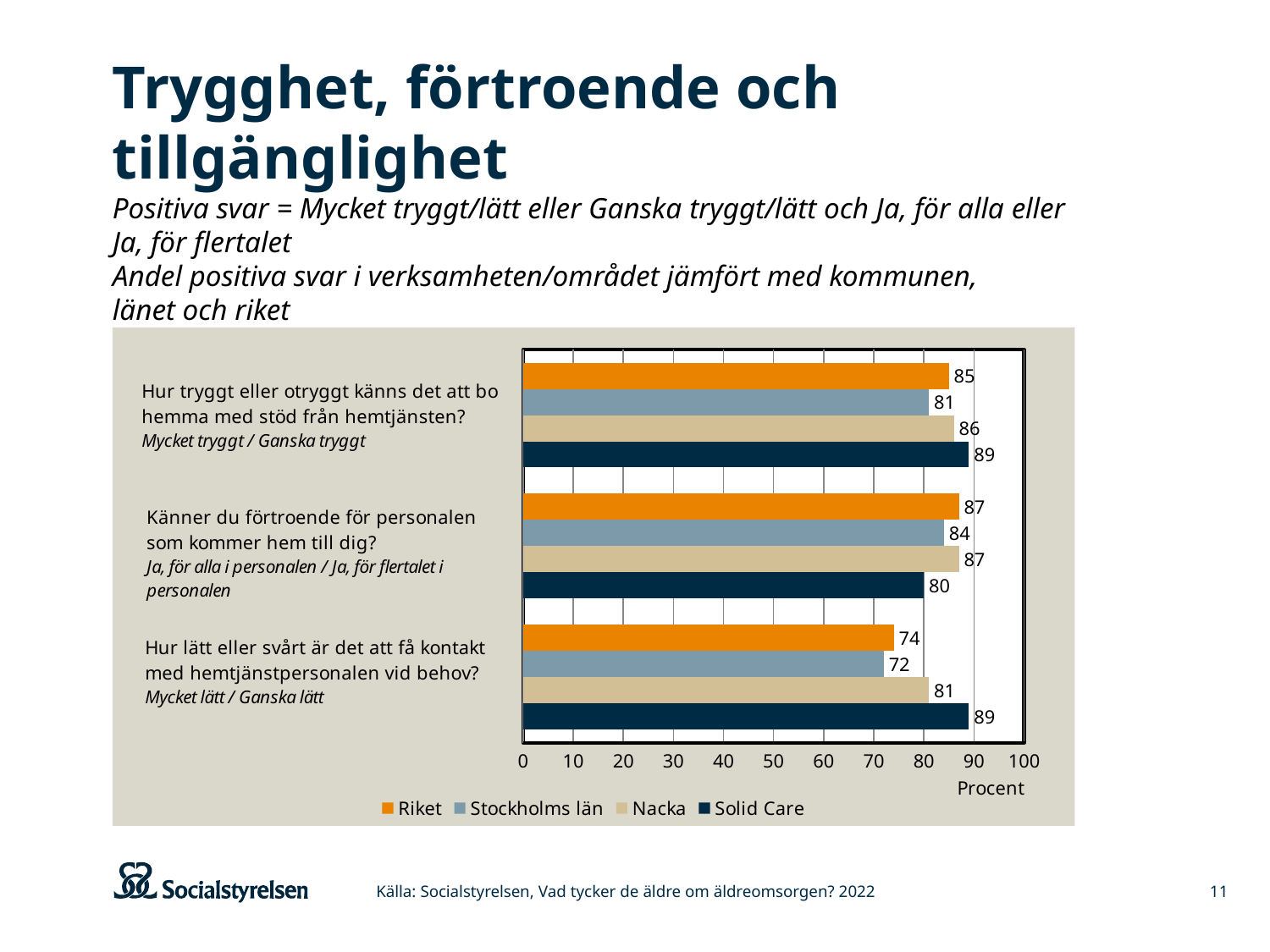
What kind of chart is shown on the slide? Bar chart How many question categories are plotted on the chart? 3 How many series does the legend list? 4 What is the value for Solid Care on the question "Hur tryggt eller otryggt känns det att bo hemma med stöd från hemtjänsten?"? 89 Which series has the highest value on the question "Hur lätt eller svårt är det att få kontakt med hemtjänstpersonalen vid behov?"? Solid Care What is the value for Stockholms län on the question "Känner du förtroende för personalen som kommer hem till dig?"? 84 What is the difference between Solid Care and Stockholms län on the question "Hur lätt eller svårt är det att få kontakt med hemtjänstpersonalen vid behov?"? 17 Which series is shown in orange in the legend? Riket Which series has the lowest value on the question "Känner du förtroende för personalen som kommer hem till dig?"? Solid Care What is the value for Riket on the question "Hur lätt eller svårt är det att få kontakt med hemtjänstpersonalen vid behov?"? 74 Which is larger on the question "Hur tryggt eller otryggt känns det att bo hemma med stöd från hemtjänsten?": Nacka or Riket? Nacka What is the label on the horizontal axis of the chart? Procent